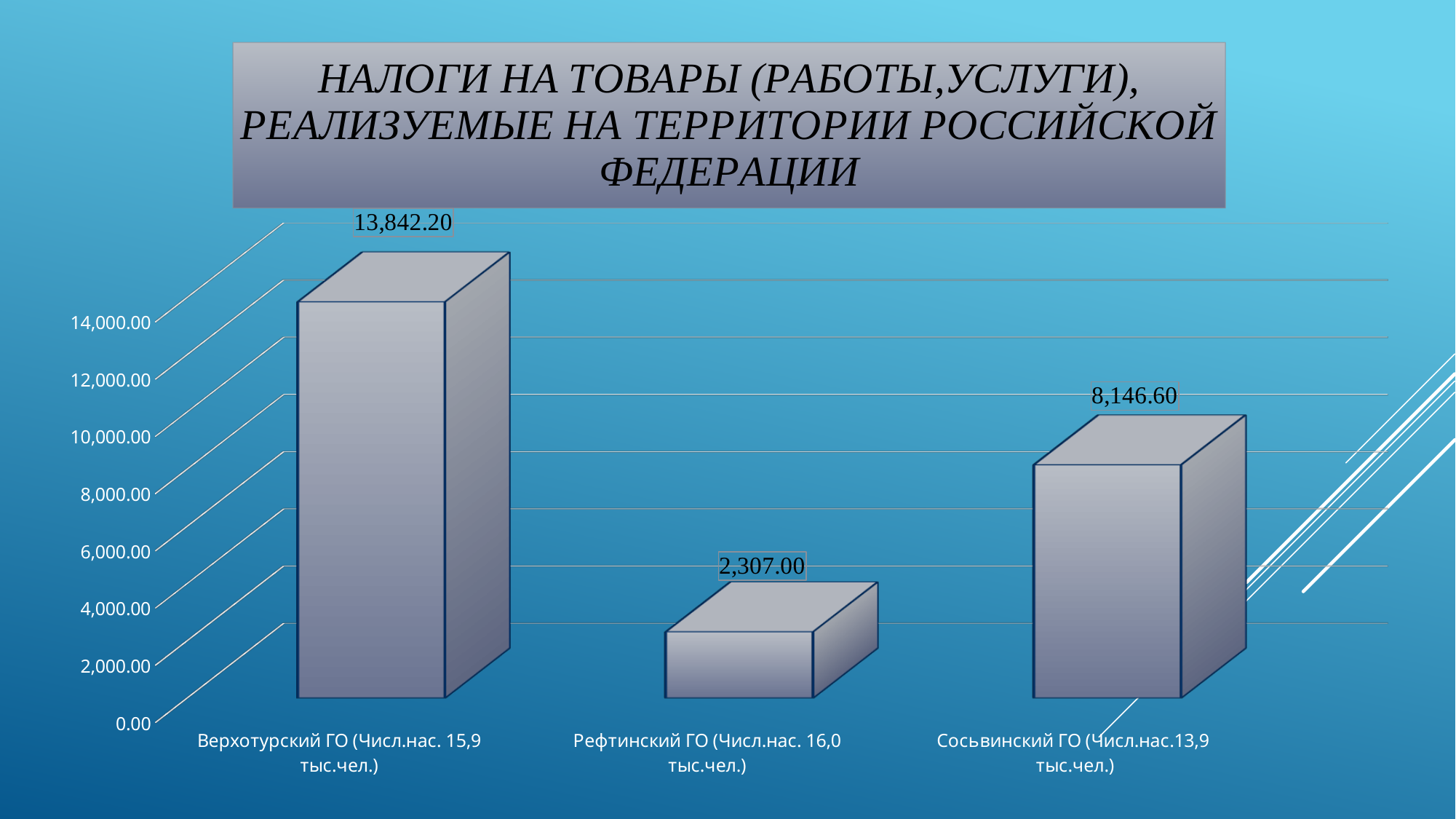
Which is larger, the value for Сосьвинский ГО or the value for Рефтинский ГО? Сосьвинский ГО How many categories are shown on the chart? 3 Which category has the highest value? Верхотурский ГО (Числ.нас. 15,9 тыс.чел.) What kind of chart is shown on the slide? Bar chart What is the difference between the values for Сосьвинский ГО and Рефтинский ГО? 5,839.60 Which category has the lowest value? Рефтинский ГО (Числ.нас. 16,0 тыс.чел.) What is the value for Рефтинский ГО (Числ.нас. 16,0 тыс.чел.)? 2,307.00 What is the difference between the values for Верхотурский ГО and Сосьвинский ГО? 5,695.60 What is the title of the chart? НАЛОГИ НА ТОВАРЫ (РАБОТЫ,УСЛУГИ), РЕАЛИЗУЕМЫЕ НА ТЕРРИТОРИИ РОССИЙСКОЙ ФЕДЕРАЦИИ What is the value for Сосьвинский ГО (Числ.нас.13,9 тыс.чел.)? 8,146.60 Is the value for Сосьвинский ГО greater or less than 10,000.00? less What is the value for Верхотурский ГО (Числ.нас. 15,9 тыс.чел.)? 13,842.20